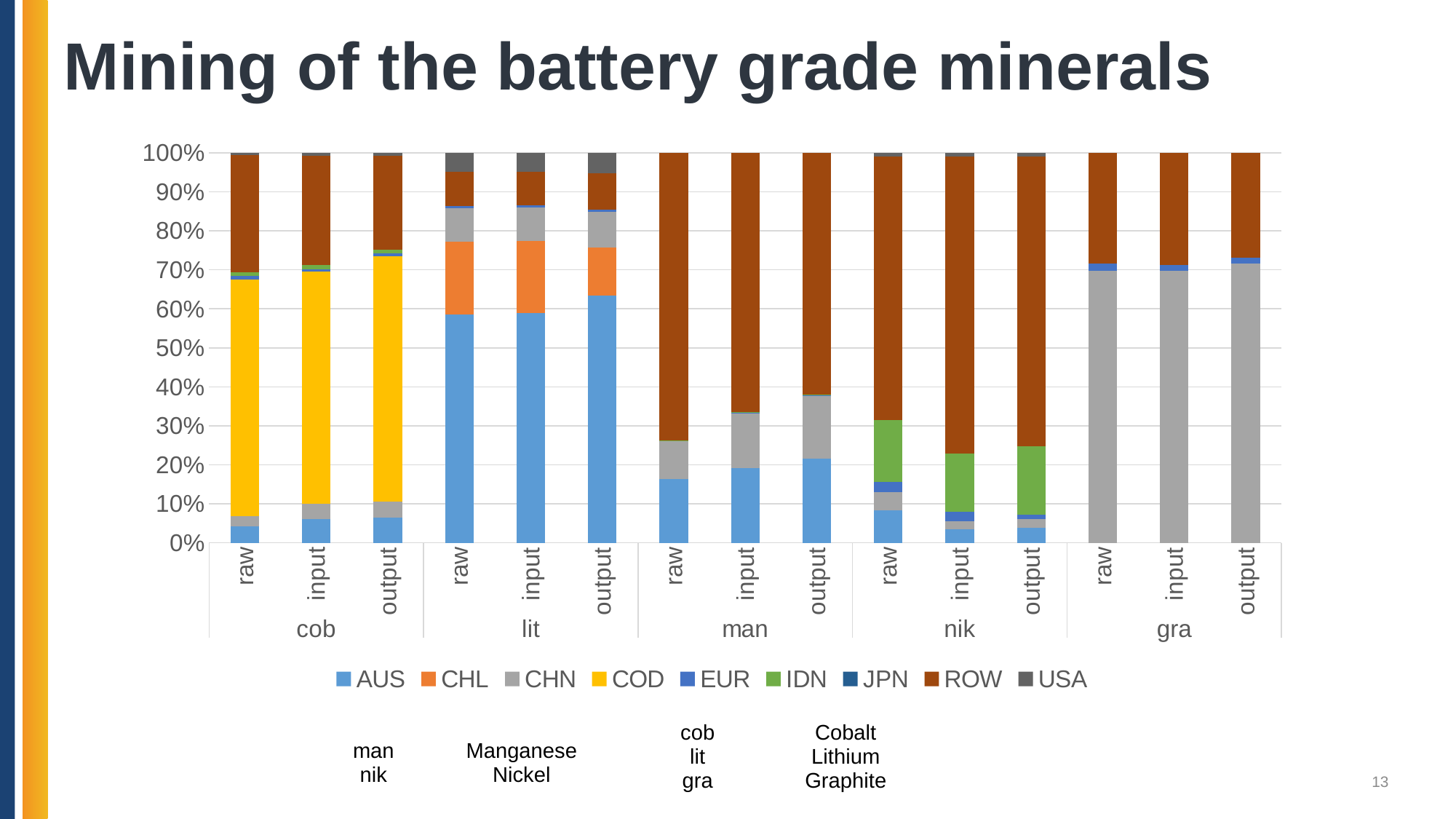
How many mineral groups are shown along the x axis? 5 How many bars are plotted in total? 15 How many series does the legend list? 9 Is the ROW share of the man raw bar greater or less than 70%? greater Is the AUS share of the man raw bar greater or less than 20%? less Which series makes up the largest share of the gra output bar? CHN Is the AUS share of the lit raw bar greater or less than 50%? greater Which series makes up the largest share of the lit raw bar? AUS Which series is shown in yellow in the legend? COD What kind of chart is shown on the slide? stacked bar chart Which series makes up the largest share of the cob raw bar? COD Which bar has the larger ROW share, man raw or cob raw? man raw